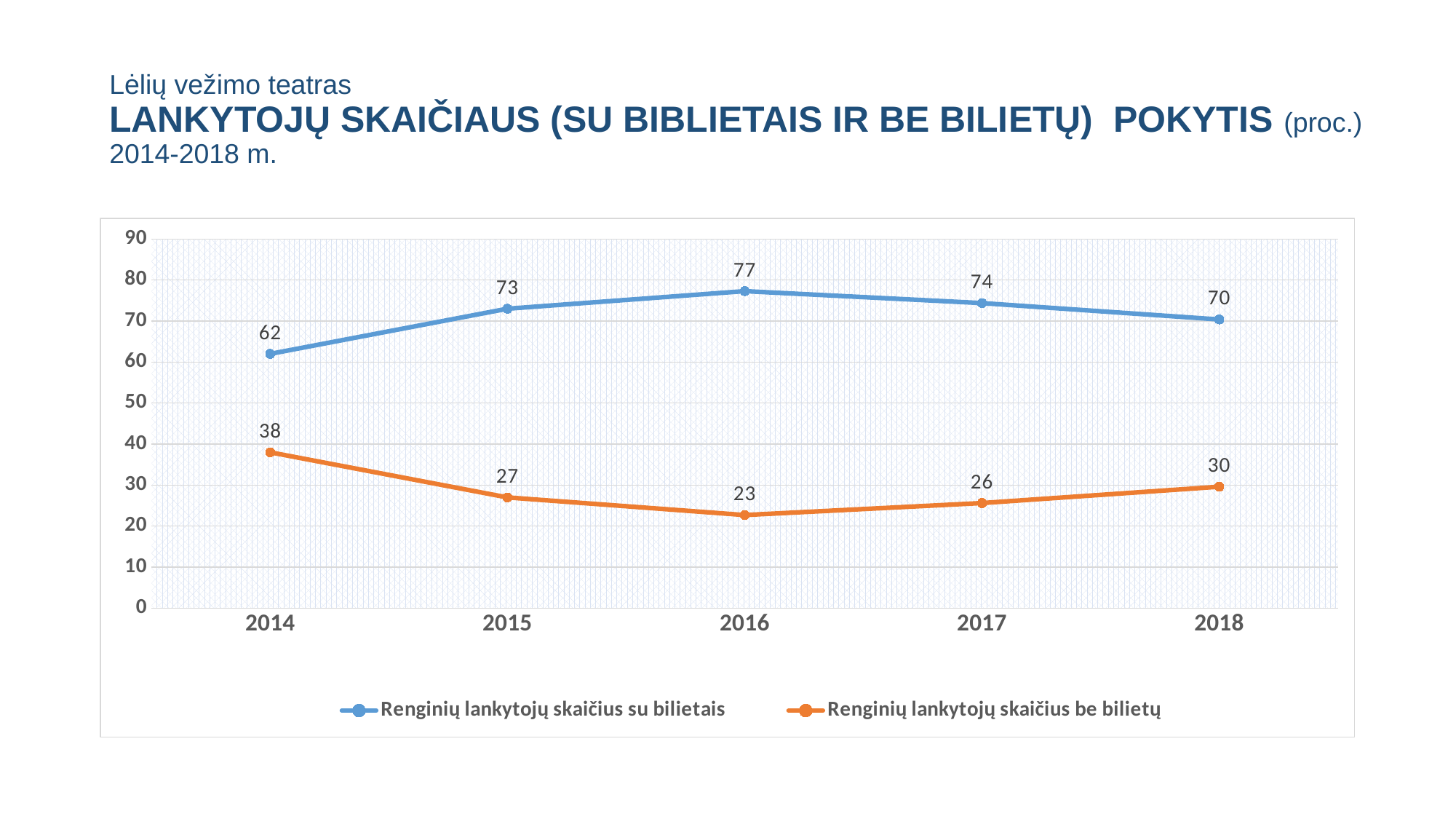
What is the value for "Renginių lankytojų skaičius be bilietų" in 2018? 30 Does the "Renginių lankytojų skaičius be bilietų" series rise or fall from 2014 to 2016? fall What kind of chart is shown on the slide? line chart How many series does the legend list? 2 What is the value for "Renginių lankytojų skaičius su bilietais" in 2016? 77 What is the difference between the "su bilietais" and "be bilietų" values in 2014? 24 How many years are shown on the x axis? 5 Is the value for "Renginių lankytojų skaičius be bilietų" in 2017 greater or less than 30? less Which is larger: the "su bilietais" value in 2015 or in 2018? 2015 In which year is "Renginių lankytojų skaičius be bilietų" lowest? 2016 In which year is "Renginių lankytojų skaičius su bilietais" highest? 2016 What is the value for "Renginių lankytojų skaičius be bilietų" in 2014? 38